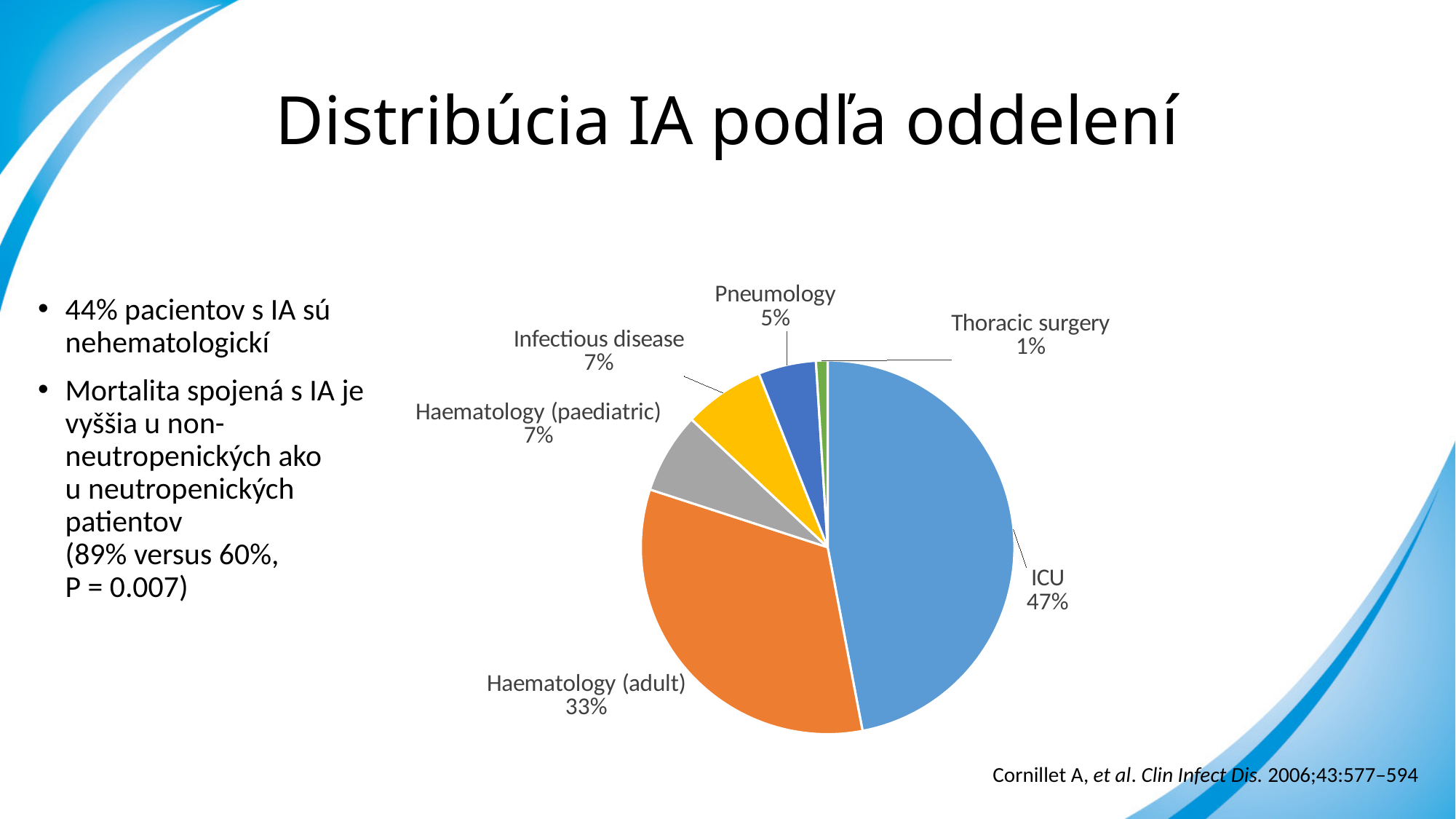
How many slices does the pie chart have? 6 What share of the pie does ICU account for? 47% Which is larger, the share for Pneumology or the share for Infectious disease? Infectious disease Which department has the largest slice of the pie? ICU What is the combined share of Haematology (adult) and Haematology (paediatric)? 40% What is the difference between the ICU share and the Haematology (adult) share? 14% What colour is the ICU slice? blue Which department has the smallest slice of the pie? Thoracic surgery What kind of chart is shown on the slide? pie chart What is the value shown for Haematology (adult)? 33% What is the value shown for Pneumology? 5% What is the value shown for Thoracic surgery? 1%